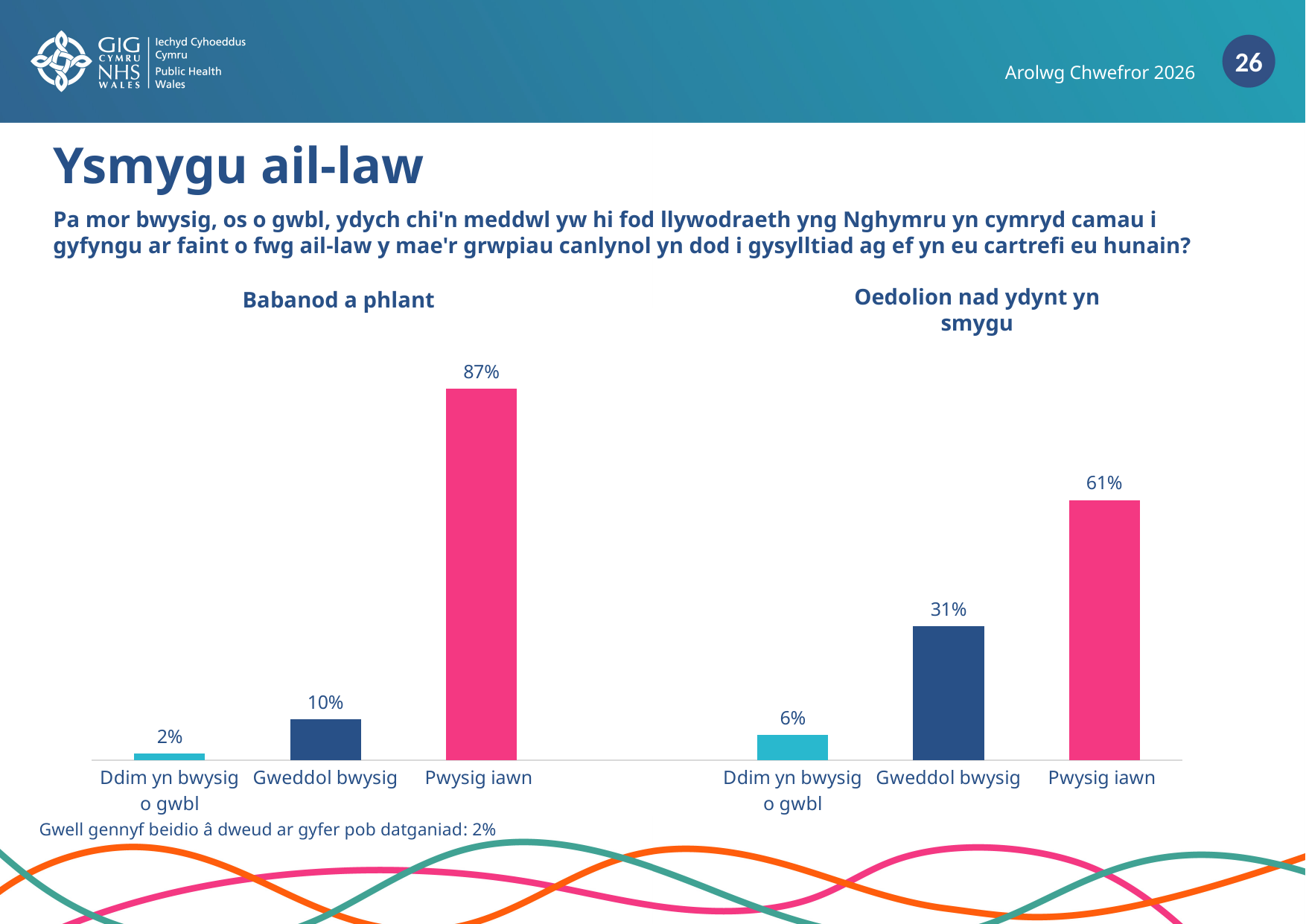
In the 'Oedolion nad ydynt yn smygu' chart, what is the difference between 'Pwysig iawn' and 'Gweddol bwysig'? 30% In the 'Babanod a phlant' chart, what is the value for 'Gweddol bwysig'? 10% In the 'Babanod a phlant' chart, do the values rise or fall from left to right? Rise What type of chart is the 'Oedolion nad ydynt yn smygu' chart? Bar chart In the 'Oedolion nad ydynt yn smygu' chart, which category has the highest value? Pwysig iawn In the 'Babanod a phlant' chart, which category has the lowest value? Ddim yn bwysig o gwbl Which is larger: 'Gweddol bwysig' in the 'Babanod a phlant' chart or 'Gweddol bwysig' in the 'Oedolion nad ydynt yn smygu' chart? Oedolion nad ydynt yn smygu In the 'Babanod a phlant' chart, what is the value for 'Pwysig iawn'? 87% How many categories are shown in the 'Babanod a phlant' chart? 3 In the 'Oedolion nad ydynt yn smygu' chart, what is the value for 'Gweddol bwysig'? 31% What is the difference between the 'Pwysig iawn' values in the 'Babanod a phlant' chart and the 'Oedolion nad ydynt yn smygu' chart? 26% In the 'Oedolion nad ydynt yn smygu' chart, what is the value for 'Ddim yn bwysig o gwbl'? 6%